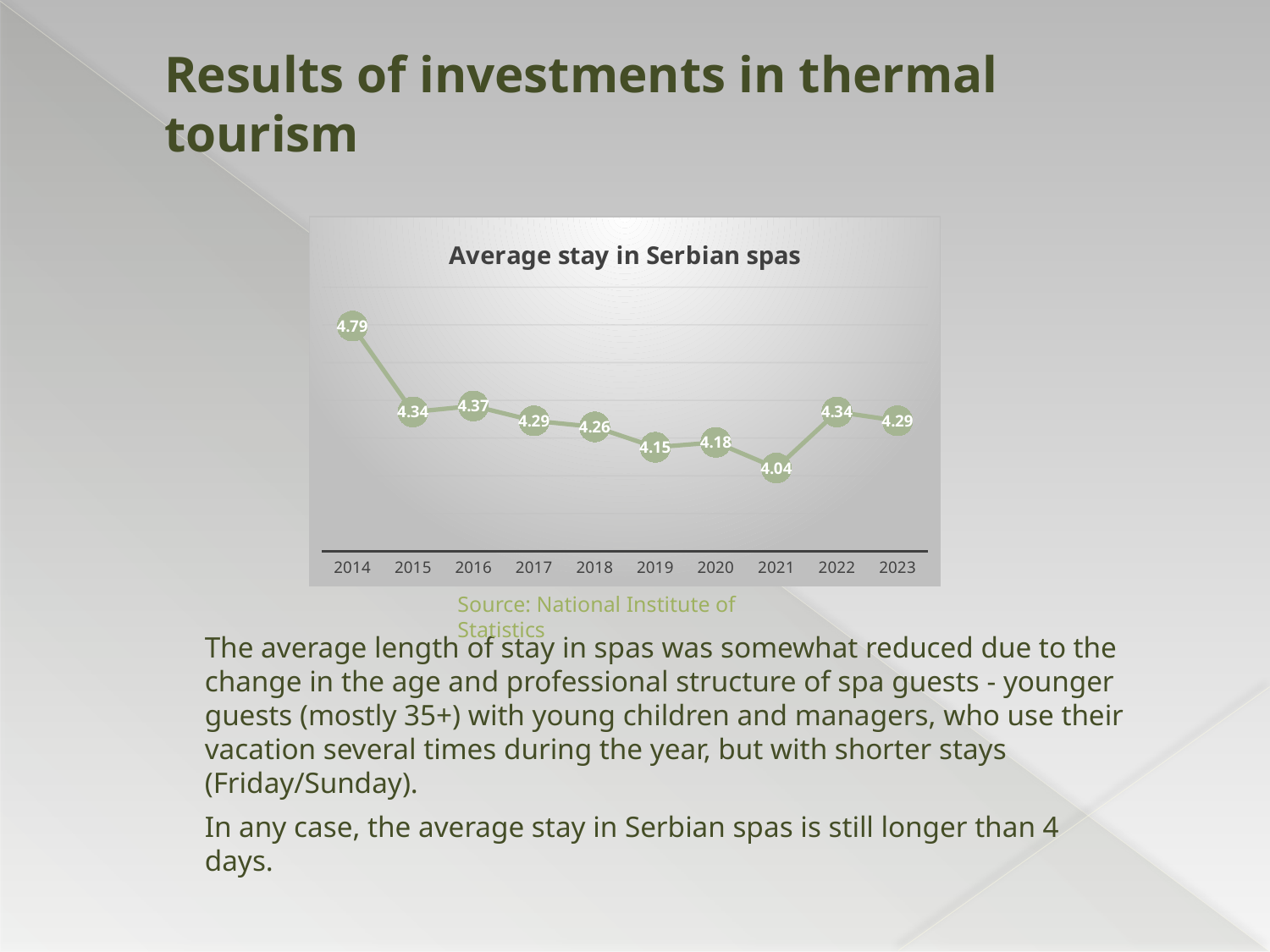
What kind of chart is shown on the slide? Line chart What is the average stay in Serbian spas in 2023? 4.29 Which year has a higher average stay, 2016 or 2020? 2016 Which year has the highest average stay in Serbian spas? 2014 What is the average stay in Serbian spas in 2019? 4.15 What is the average stay in Serbian spas in 2021? 4.04 What is the average stay in Serbian spas in 2014? 4.79 How many years are plotted in the chart? 10 Which year has the lowest average stay in Serbian spas? 2021 What is the difference between the average stay in 2014 and in 2021? 0.75 What is the difference between the average stay in 2022 and in 2023? 0.05 What is the title of the chart? Average stay in Serbian spas